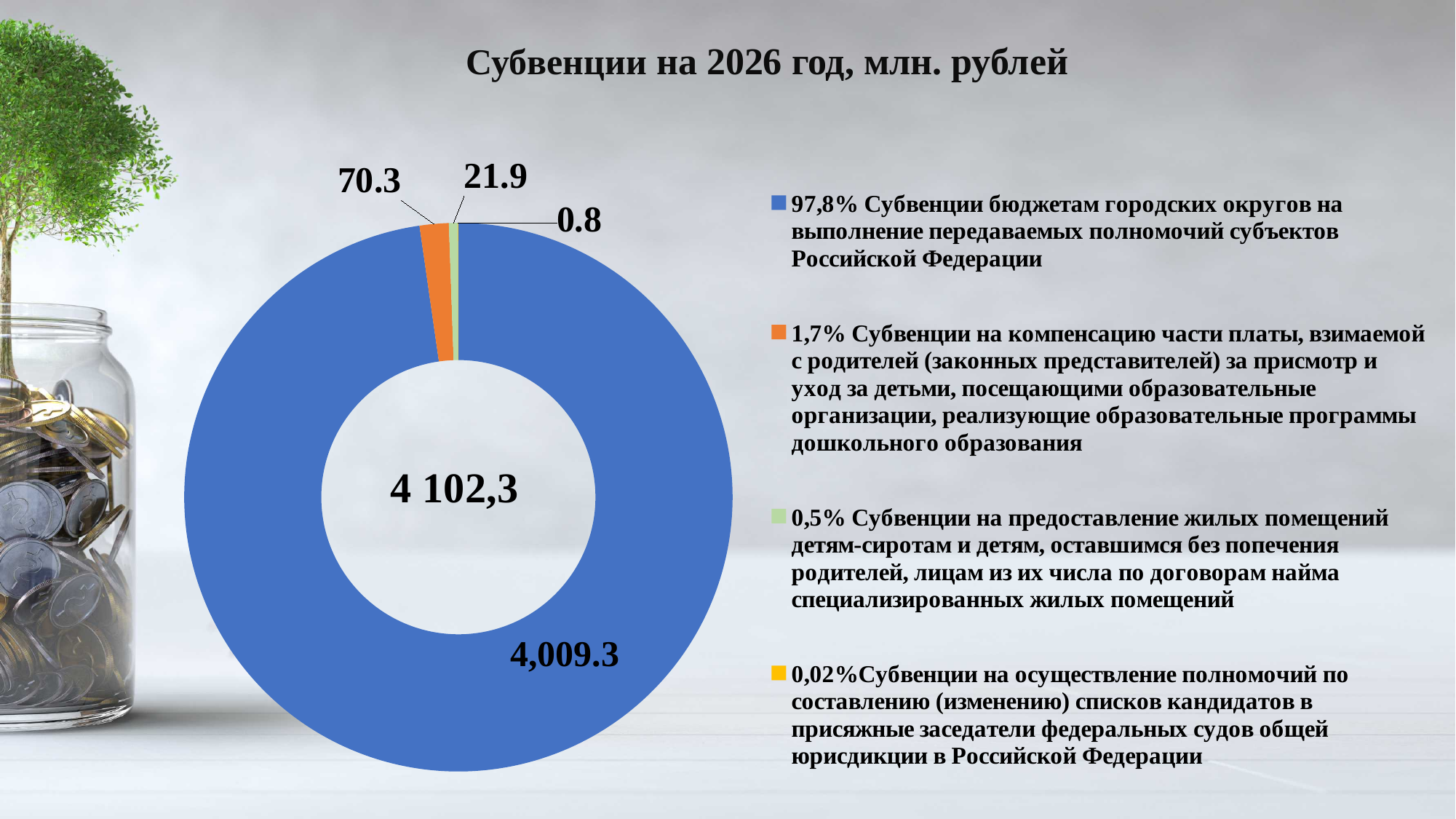
What is the difference between the value for Субвенции на компенсацию части платы (70.3) and the value for Субвенции на предоставление жилых помещений детям-сиротам (21.9)? 48.4 What total value is shown in the centre of the doughnut chart? 4 102,3 How many series does the legend list? 4 Which category has the smallest value? Субвенции на осуществление полномочий по составлению (изменению) списков кандидатов в присяжные заседатели федеральных судов общей юрисдикции в Российской Федерации What is the value for Субвенции бюджетам городских округов на выполнение передаваемых полномочий субъектов Российской Федерации? 4,009.3 What is the value for Субвенции на компенсацию части платы, взимаемой с родителей (законных представителей) за присмотр и уход за детьми? 70.3 Which category has the largest value? Субвенции бюджетам городских округов на выполнение передаваемых полномочий субъектов Российской Федерации What is the value for Субвенции на предоставление жилых помещений детям-сиротам и детям, оставшимся без попечения родителей? 21.9 What is the value for Субвенции на осуществление полномочий по составлению (изменению) списков кандидатов в присяжные заседатели? 0.8 What is the title of the chart? Субвенции на 2026 год, млн. рублей What share of the total does Субвенции бюджетам городских округов на выполнение передаваемых полномочий субъектов Российской Федерации represent, according to the legend? 97,8% What kind of chart is shown on the slide? doughnut chart